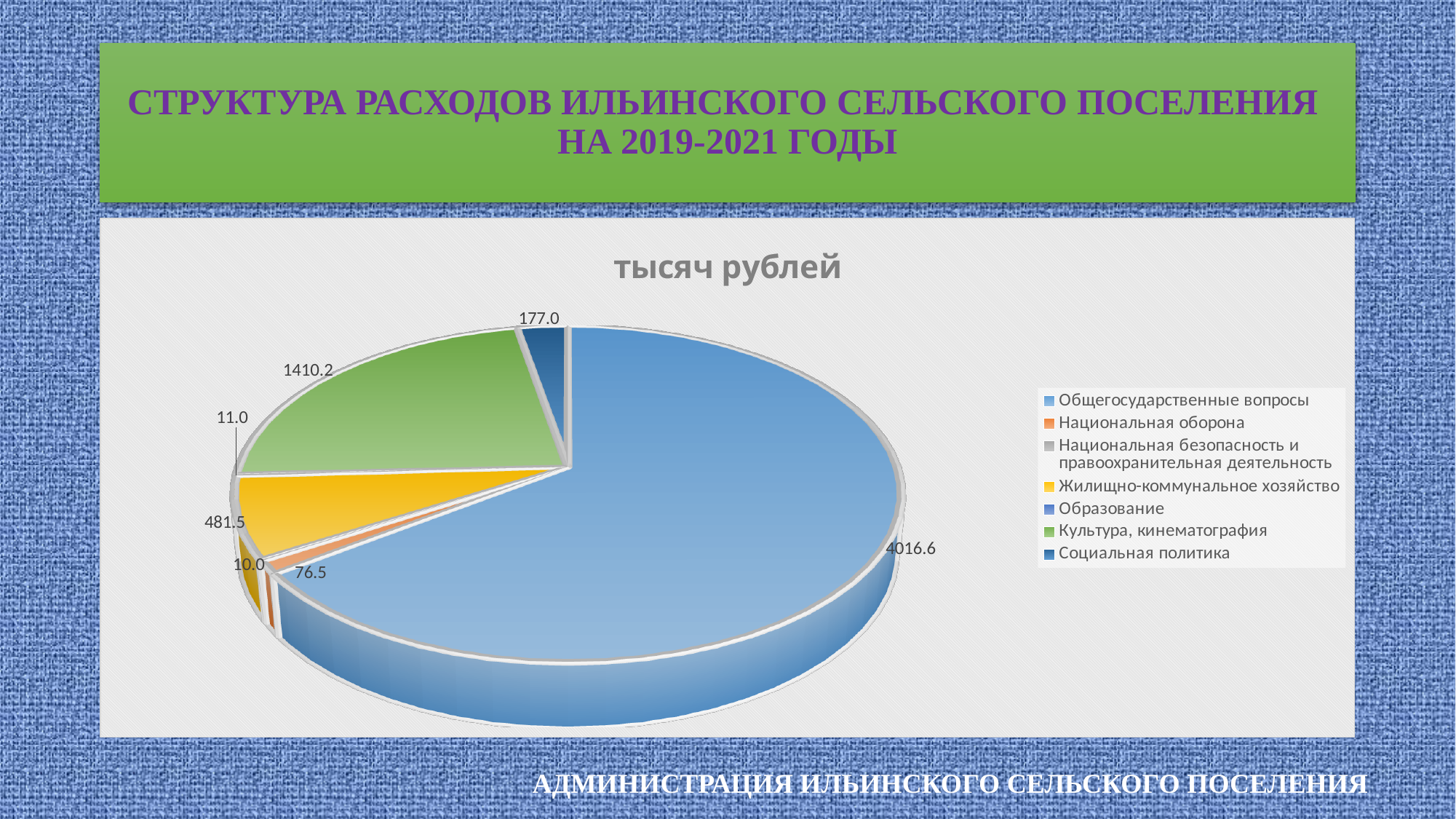
Which is larger, the value for Жилищно-коммунальное хозяйство or the value for Социальная политика? Жилищно-коммунальное хозяйство What is the value for Жилищно-коммунальное хозяйство? 481.5 What is the value for Культура, кинематография? 1410.2 What is the difference between the values for Общегосударственные вопросы and Культура, кинематография? 2606.4 How many categories does the legend of the pie chart list? 7 What is the value for Социальная политика? 177.0 What is the title of the chart? тысяч рублей What is the value for Общегосударственные вопросы? 4016.6 What is the value for Национальная оборона? 76.5 What kind of chart is shown on the slide? pie chart Which category has the smallest value in the pie chart? Национальная безопасность и правоохранительная деятельность Which category has the largest slice of the pie? Общегосударственные вопросы